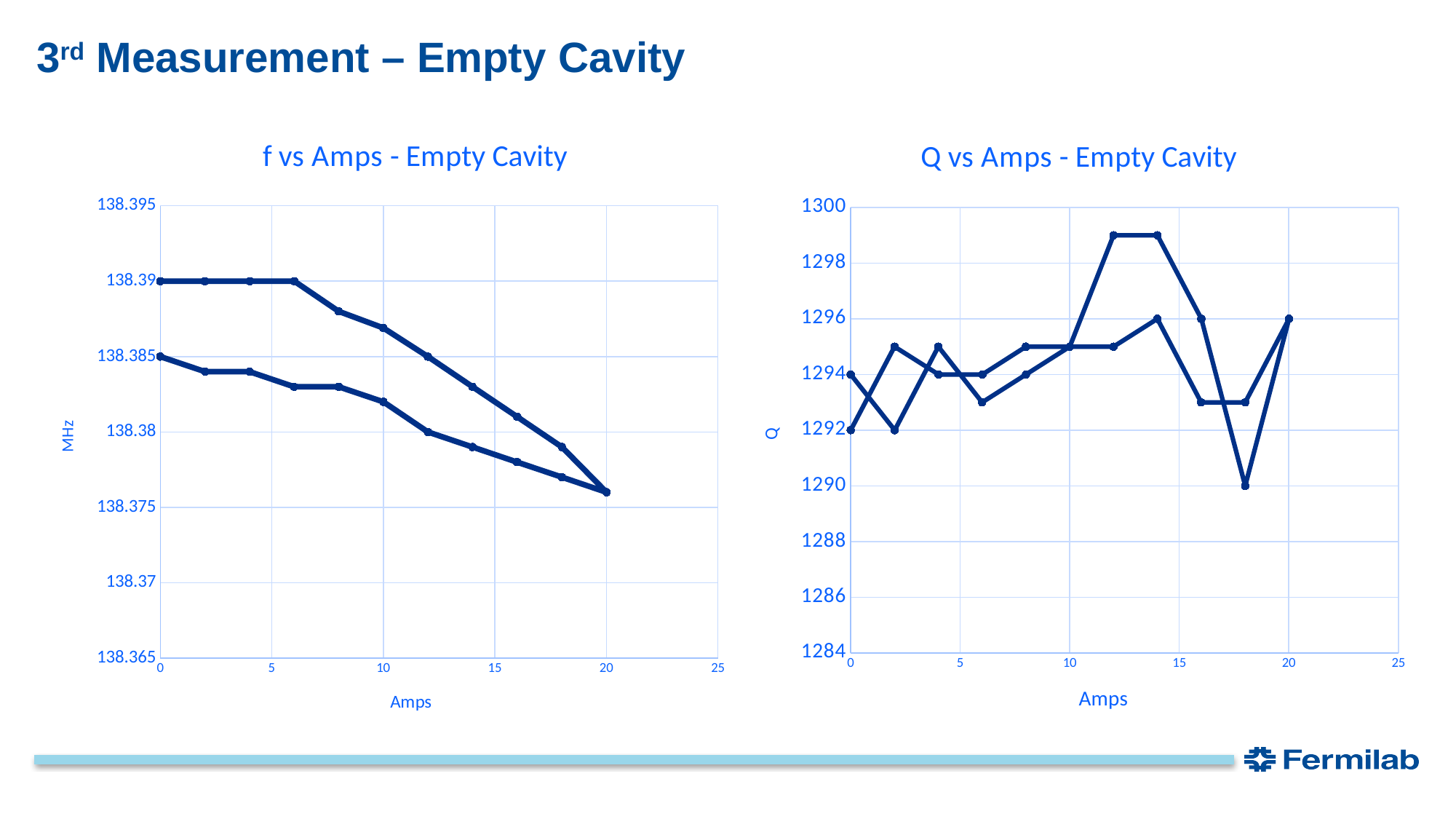
In the 'Q vs Amps - Empty Cavity' chart, what is the lowest Q value plotted? 1290 What is the y-axis label of the 'f vs Amps - Empty Cavity' chart? MHz In the 'f vs Amps - Empty Cavity' chart, what is the value of the lower line at 0 Amps? 138.385 What kind of chart is the 'f vs Amps - Empty Cavity' chart? line chart In the 'Q vs Amps - Empty Cavity' chart, what is the Q value where both lines meet at 20 Amps? 1296 In the 'f vs Amps - Empty Cavity' chart, is the value at 20 Amps greater or less than 138.38? less In the 'f vs Amps - Empty Cavity' chart, do the values rise or fall as Amps increase from 0 to 20? fall In the 'f vs Amps - Empty Cavity' chart, what is the value of the upper line at 0 Amps? 138.39 How many data points does each line have in the 'Q vs Amps - Empty Cavity' chart? 11 In the 'Q vs Amps - Empty Cavity' chart, is the highest value at 12 Amps greater or less than 1298? greater How many lines are plotted in the 'f vs Amps - Empty Cavity' chart? 2